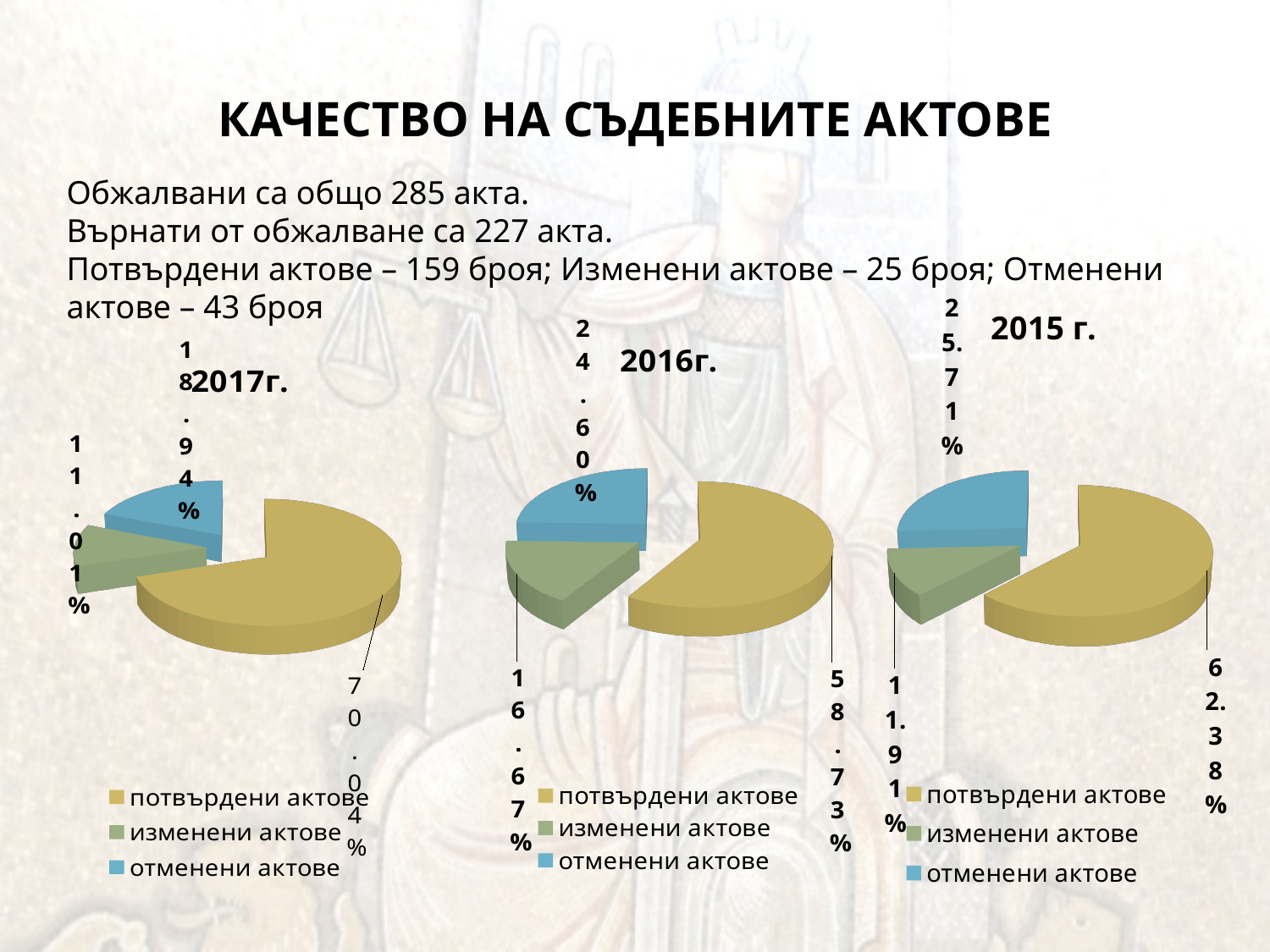
How many entries does the legend of the 2016г. chart list? 3 In the 2016г. chart, what is the difference between the shares for потвърдени актове and отменени актове? 34.13% In the 2016г. chart, what share is shown for отменени актове? 24.60% In the 2015 г. chart, which is larger: the share for отменени актове or the share for изменени актове? отменени актове What kind of chart is the 2015 г. chart? pie chart In the 2017г. chart, which category has the smallest slice? изменени актове How many charts are shown on the slide? 3 In the 2016г. chart, which category has the largest slice? потвърдени актове In the 2017г. chart, what share is shown for потвърдени актове? 70.04% In the 2015 г. chart, what share is shown for потвърдени актове? 62.38% In the 2015 г. chart, what share is shown for изменени актове? 11.91% How many slices does the 2017г. chart have? 3